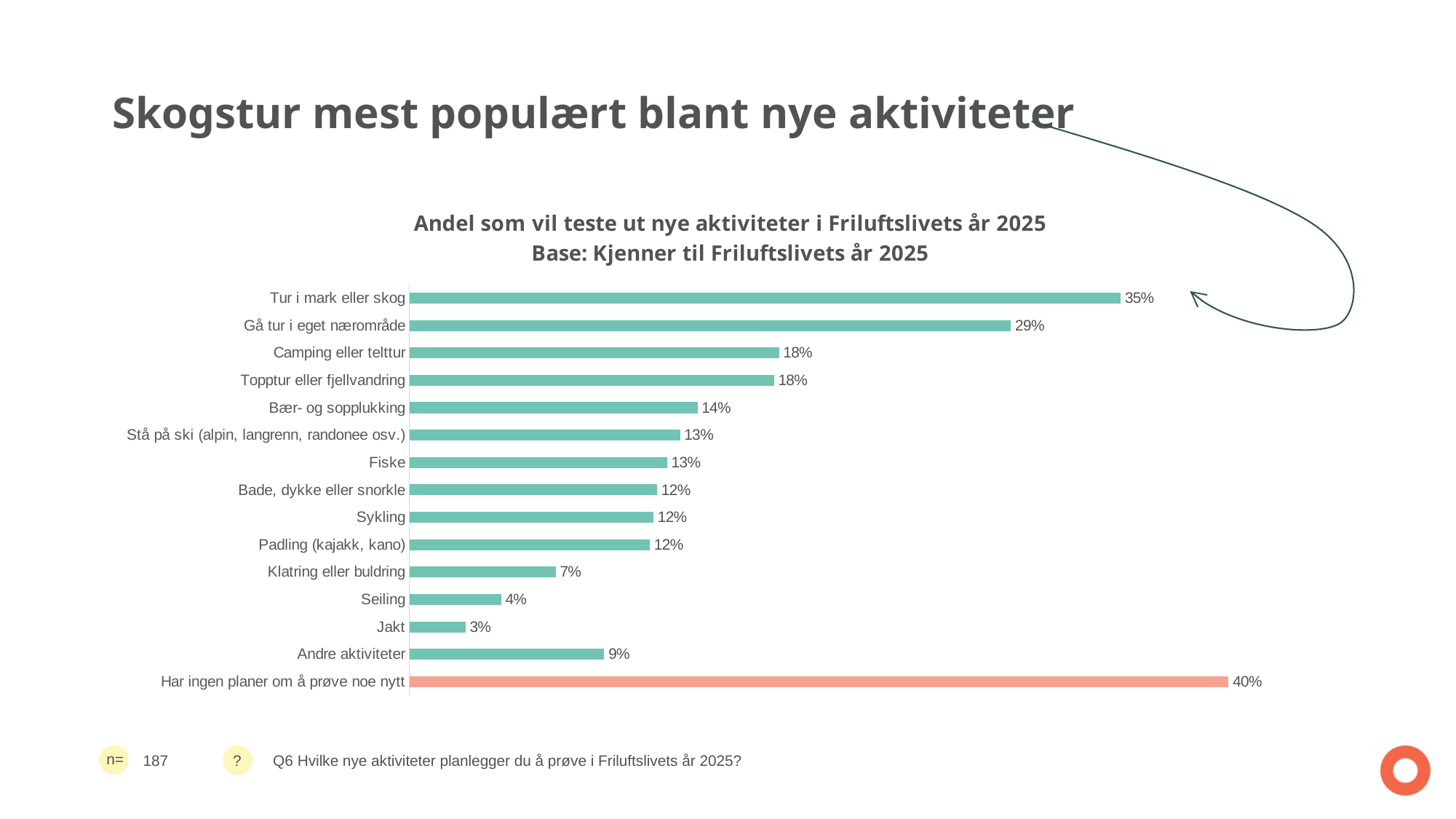
Which category has the lowest value in the chart? Jakt What is the difference between the values for "Bær- og sopplukking" and "Fiske"? 1% What is the value for "Klatring eller buldring"? 7% What is the value for "Har ingen planer om å prøve noe nytt"? 40% What is the value for "Tur i mark eller skog"? 35% What is the value for "Andre aktiviteter"? 9% What is the difference between the values for "Tur i mark eller skog" and "Gå tur i eget nærområde"? 6% Which is larger, the value for "Seiling" or the value for "Jakt"? Seiling Which category's bar is shown in a different colour (orange) from the others? Har ingen planer om å prøve noe nytt What kind of chart is shown on the slide? Bar chart Which category has the highest value in the chart? Har ingen planer om å prøve noe nytt How many categories are shown in the chart? 15